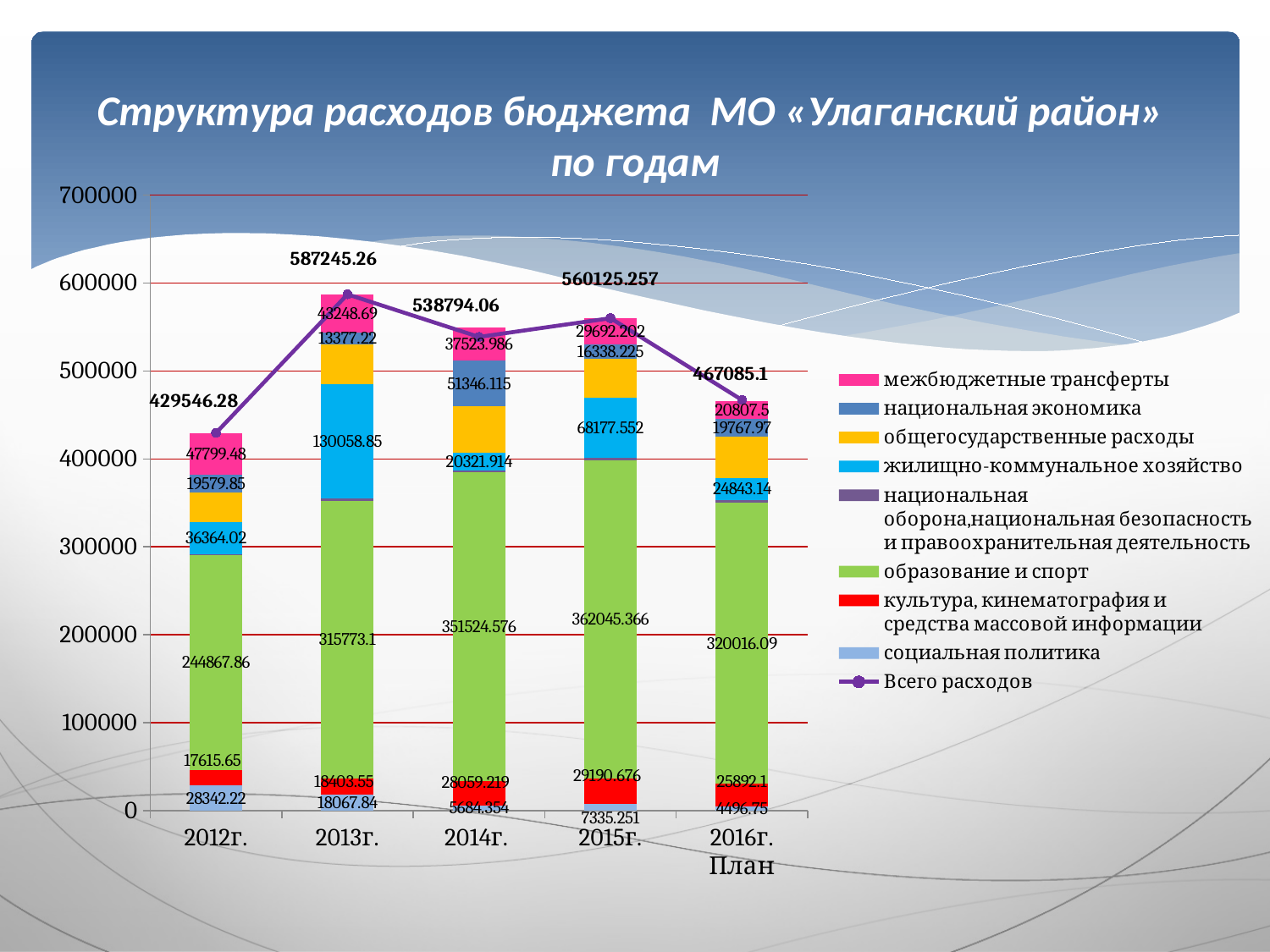
What is the value for социальная политика in 2012г.? 28342.22 What is the value for межбюджетные трансферты in 2016г. План? 20807.5 Which year has the lowest total expenditure (Всего расходов)? 2012г. How many years (categories) are shown on the x axis? 5 Does the total expenditure (Всего расходов) rise or fall from 2015г. to 2016г. План? Fall What is the total expenditure (Всего расходов) shown for 2013г.? 587245.26 What is the difference between the total expenditure in 2013г. and in 2012г.? 157698.98 How many entries does the legend list? 9 Which year has the highest total expenditure (Всего расходов)? 2013г. What is the value for образование и спорт in 2015г.? 362045.366 What kind of chart is this? Stacked bar chart with a line Which is larger: the value for социальная политика in 2012г. or in 2013г.? 2012г.